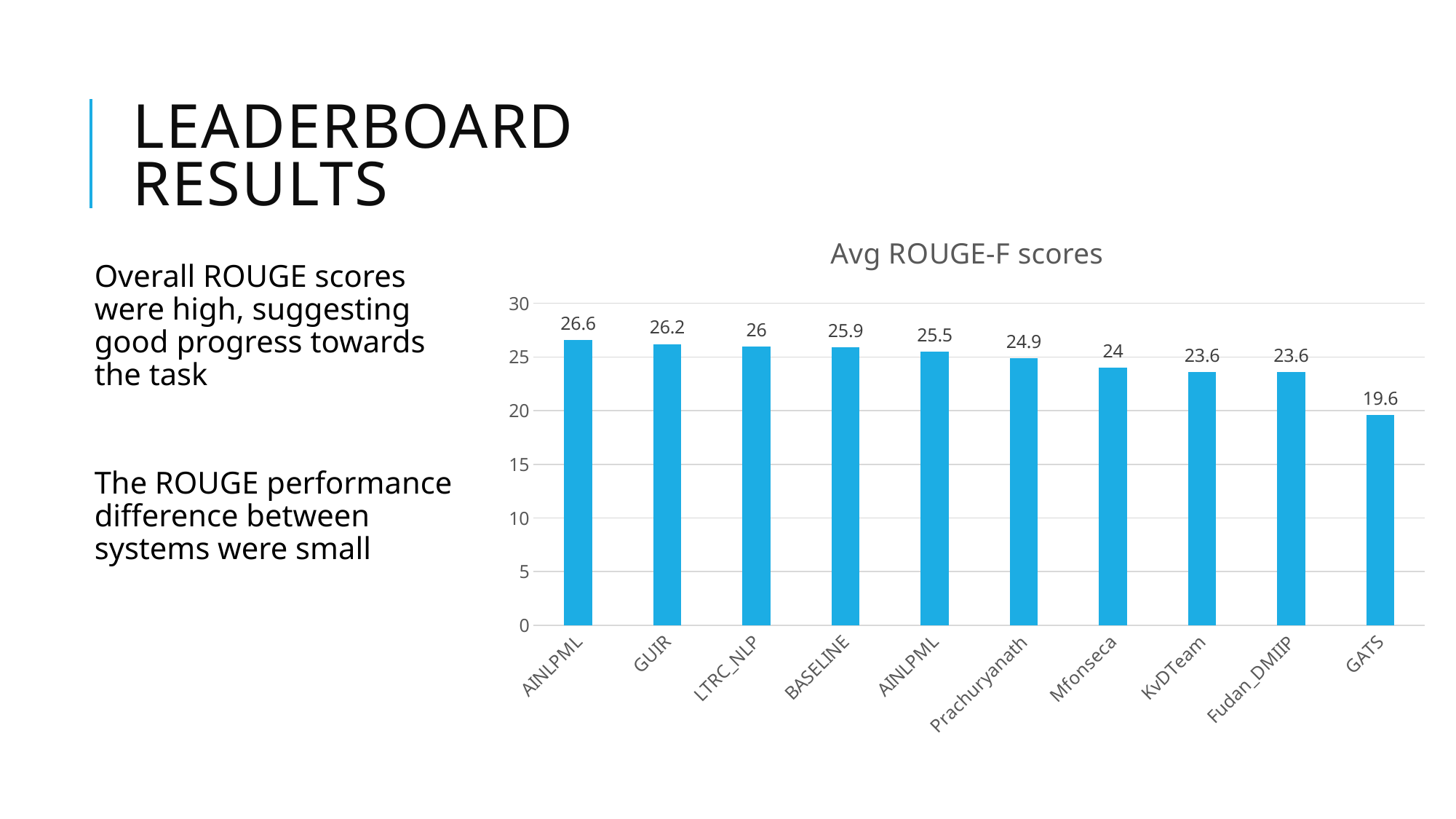
What is the Avg ROUGE-F score for GUIR? 26.2 What is the highest Avg ROUGE-F score shown on the chart? 26.6 What is the Avg ROUGE-F score for BASELINE? 25.9 What is the title of the chart on the slide? Avg ROUGE-F scores How many systems are shown on the Avg ROUGE-F scores chart? 10 Which system has the lowest Avg ROUGE-F score? GATS What is the Avg ROUGE-F score for GATS? 19.6 What is the Avg ROUGE-F score for Prachuryanath? 24.9 Is the Avg ROUGE-F score for KvDTeam greater or less than 25? less What is the difference between the Avg ROUGE-F scores of GUIR and GATS? 6.6 Which has a higher Avg ROUGE-F score, LTRC_NLP or Mfonseca? LTRC_NLP What type of chart is used to show the Avg ROUGE-F scores? bar chart